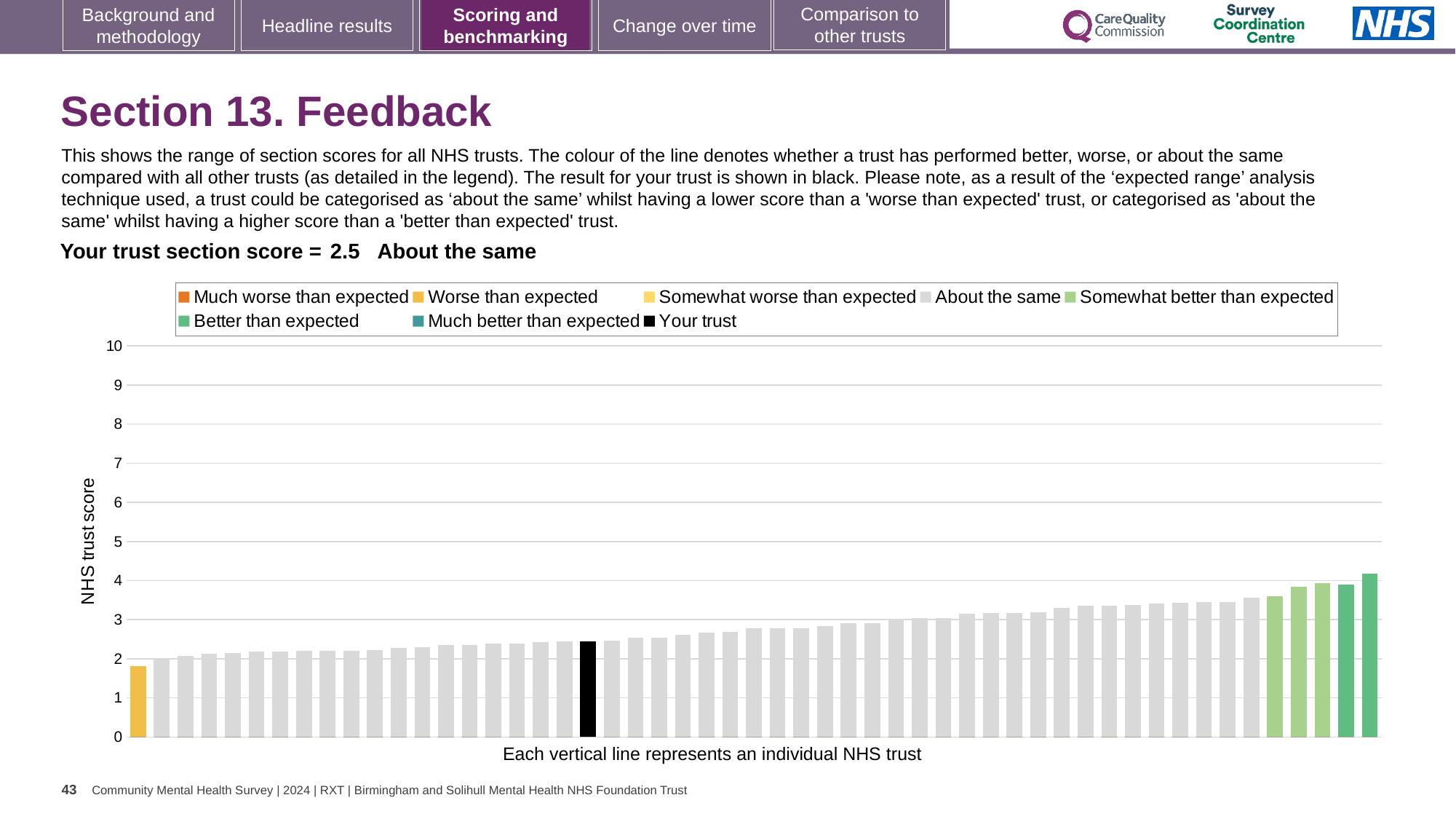
What colour is the bar representing your trust? Black What is the section score for your trust shown on the slide? 2.5 Is your trust's section score greater or less than 3? less How is your trust's section score categorised compared with other trusts? About the same Is the value of the leftmost bar in the chart greater or less than 3? less What kind of chart is shown on the slide? Bar chart Is your trust's section score greater or less than 2? greater How many bars in the chart are coloured black? 1 How many entries does the chart legend list? 8 What is the label on the vertical axis of the chart? NHS trust score Do the bar values rise or fall from left to right across the chart? rise